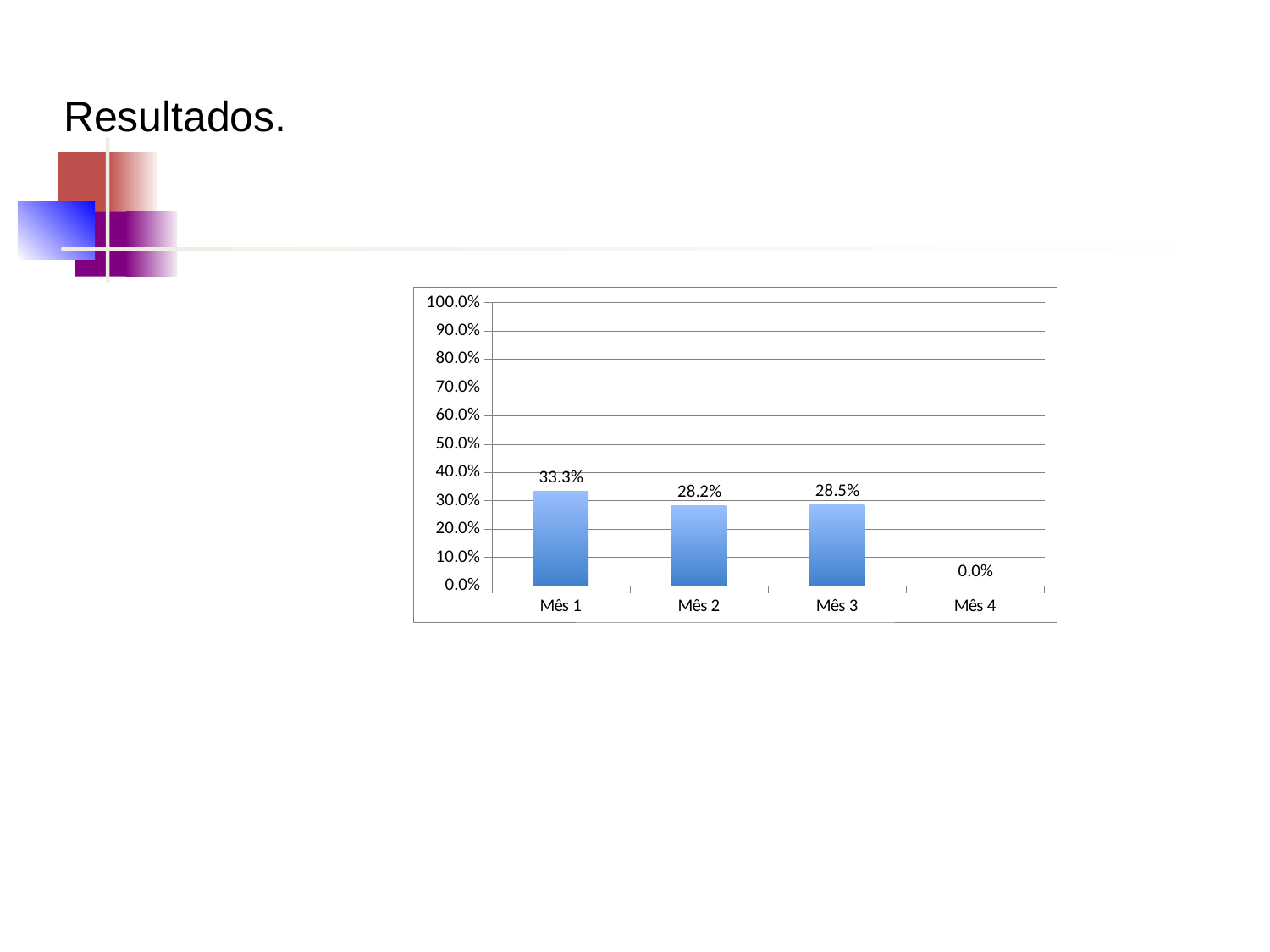
Which category has the lowest value? Mês 4 What kind of chart is shown on the slide? bar chart How many categories are shown on the x axis? 4 What is the difference between the values for Mês 1 and Mês 2? 5.1% What is the value for Mês 2? 28.2% Which category has the highest value? Mês 1 What is the value for Mês 3? 28.5% Which is larger, the value for Mês 1 or the value for Mês 3? Mês 1 What is the difference between the values for Mês 3 and Mês 2? 0.3% Is the value for Mês 1 greater or less than 30.0%? greater What is the value for Mês 4? 0.0% What is the value for Mês 1? 33.3%